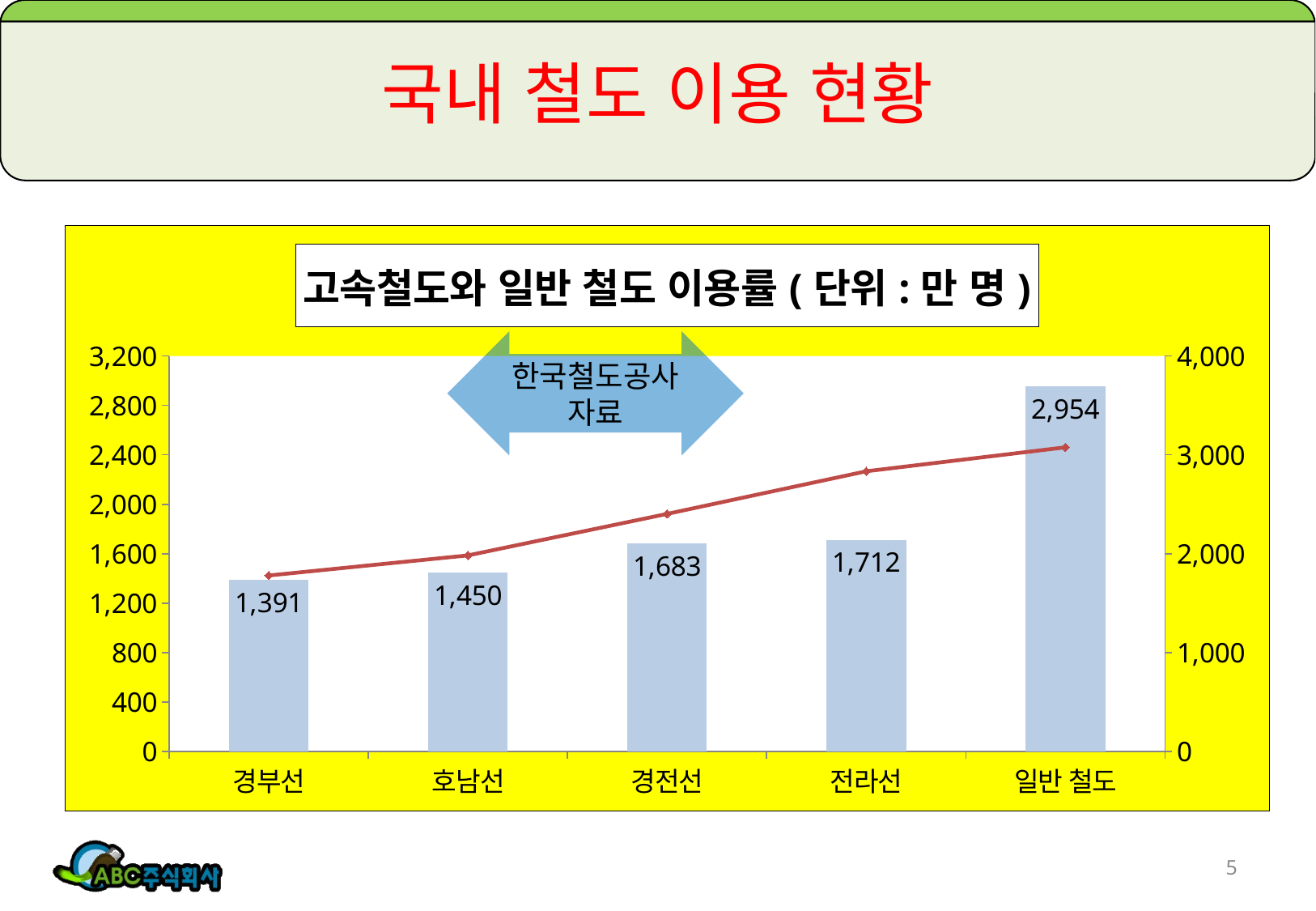
How many categories are shown on the x axis? 5 What is the value shown for 호남선? 1,450 Do the bar values rise or fall from 경부선 to 일반 철도? rise What is the value shown for 일반 철도? 2,954 What kind of chart is this? bar chart with a line Which has the larger bar value, 경전선 or 전라선? 전라선 What is the difference between the values for 일반 철도 and 전라선? 1,242 Which category has the lowest bar value? 경부선 What is the difference between the values for 호남선 and 경부선? 59 On the right-hand axis, is the line value for 경전선 greater or less than 2,000? greater Which category has the highest bar value? 일반 철도 What is the value shown for 경부선? 1,391